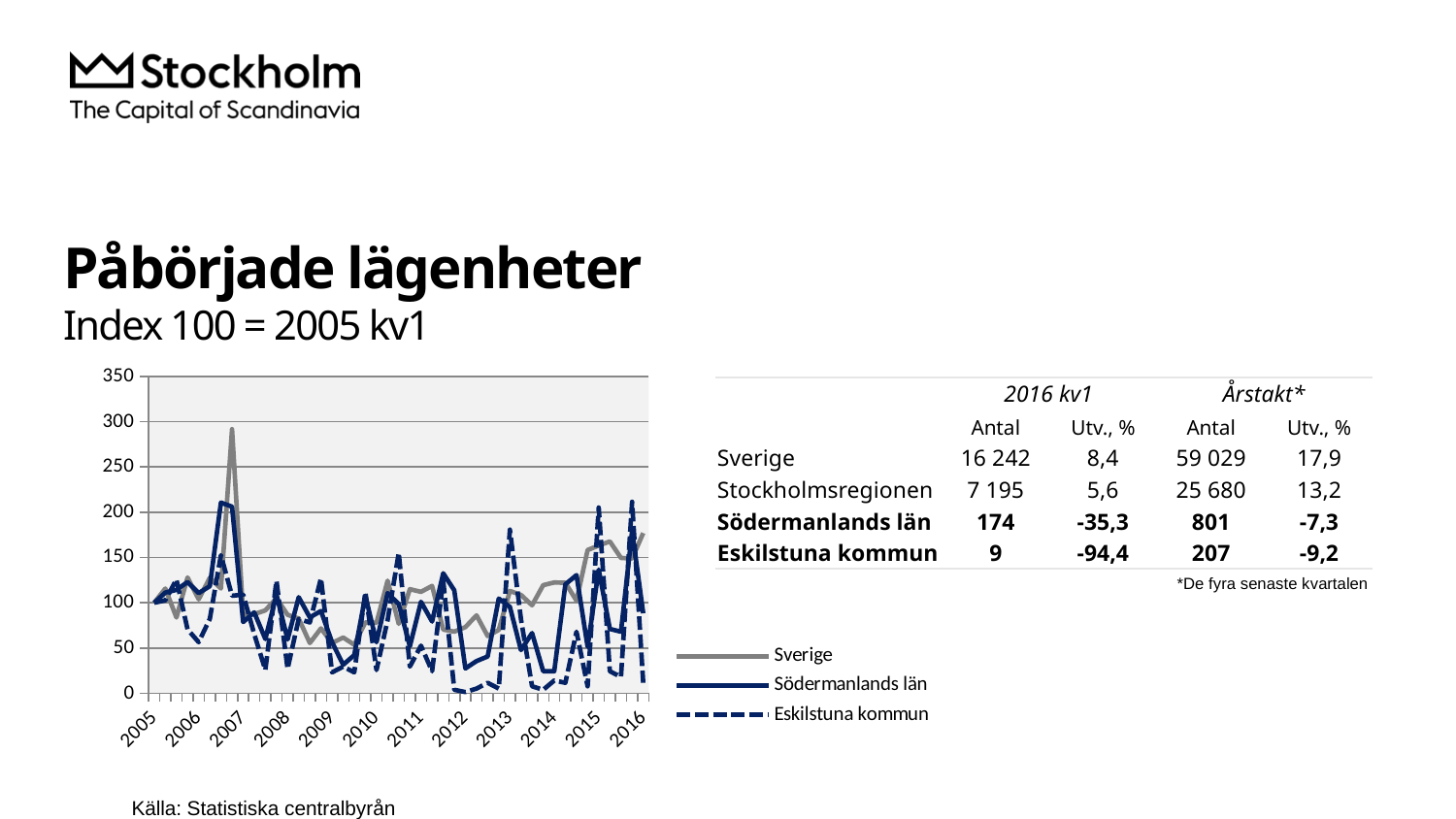
Does the Sverige line rise or fall between its 2007 peak and 2009? fall What is the highest value shown on the chart's vertical axis? 350 Which series reaches the highest peak in the chart? Sverige How many series does the chart's legend list? 3 Does the Sverige line rise or fall between 2013 and 2015? rise Is the peak value of the Södermanlands län line around 2006–2007 greater or less than 150? greater Is the peak value of the Sverige line around 2007 greater or less than 250? greater How many year labels are shown along the chart's x axis? 12 Is the value of the Eskilstuna kommun line around 2012 greater or less than 50? less What kind of chart is shown on the slide? Line chart Which series is drawn with a dashed line in the chart? Eskilstuna kommun Which series falls to the lowest values around 2012 in the chart? Eskilstuna kommun